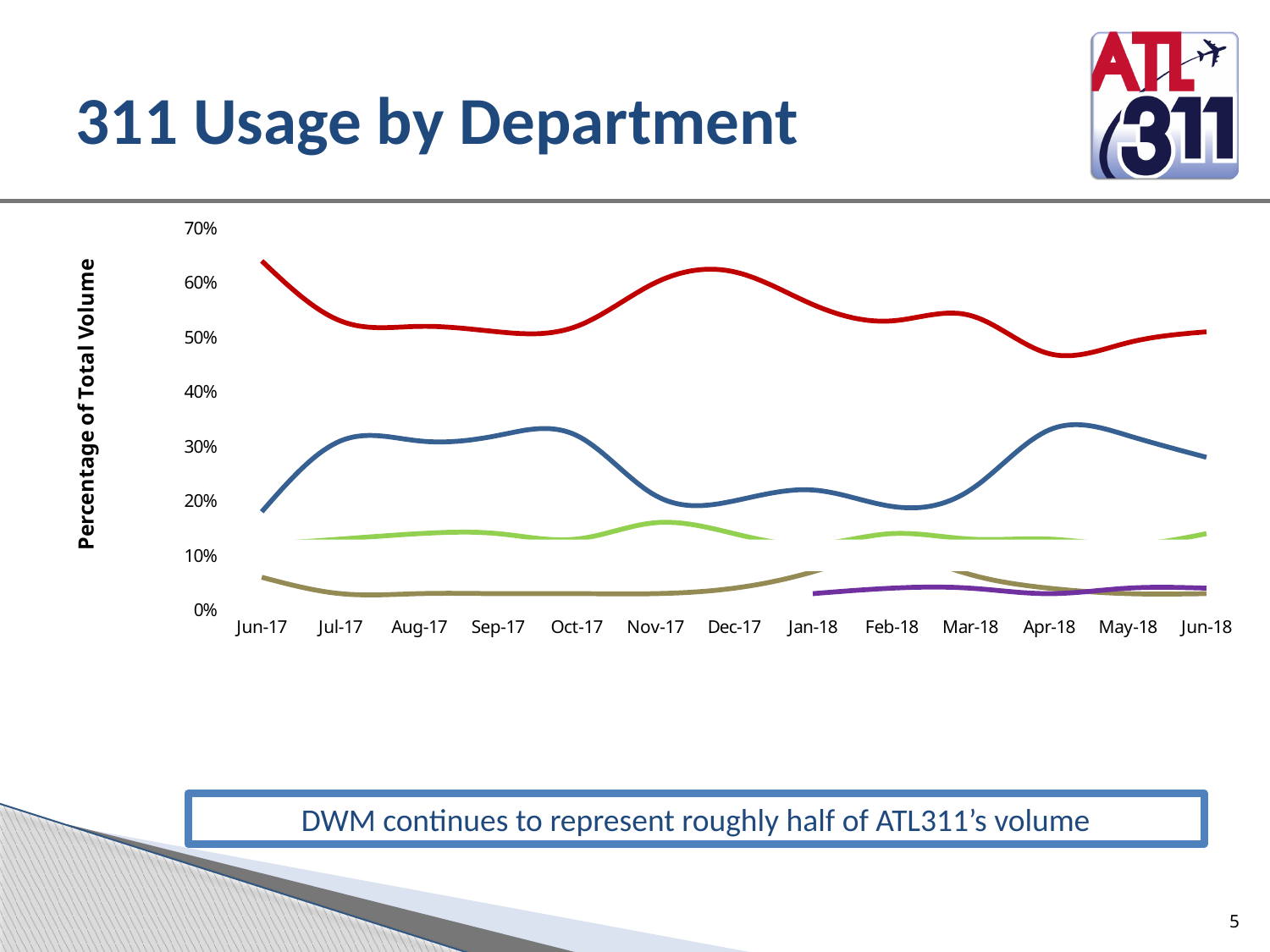
Does the red line rise or fall from Jun-17 to Jul-17? Fall Is the value of the blue line at Apr-18 greater or less than 30%? greater Is the value of the red line at Apr-18 greater or less than 50%? less In which month does the red line reach its lowest value? Apr-18 Is the value of the red line at Jun-17 greater or less than 60%? greater What is the first month shown on the x axis of the chart? Jun-17 How many months are shown along the x axis of the chart? 13 At Dec-17, which line has the higher value, the red line or the blue line? The red line What is the label of the vertical axis of the chart? Percentage of Total Volume What kind of chart is shown on the slide? Line chart